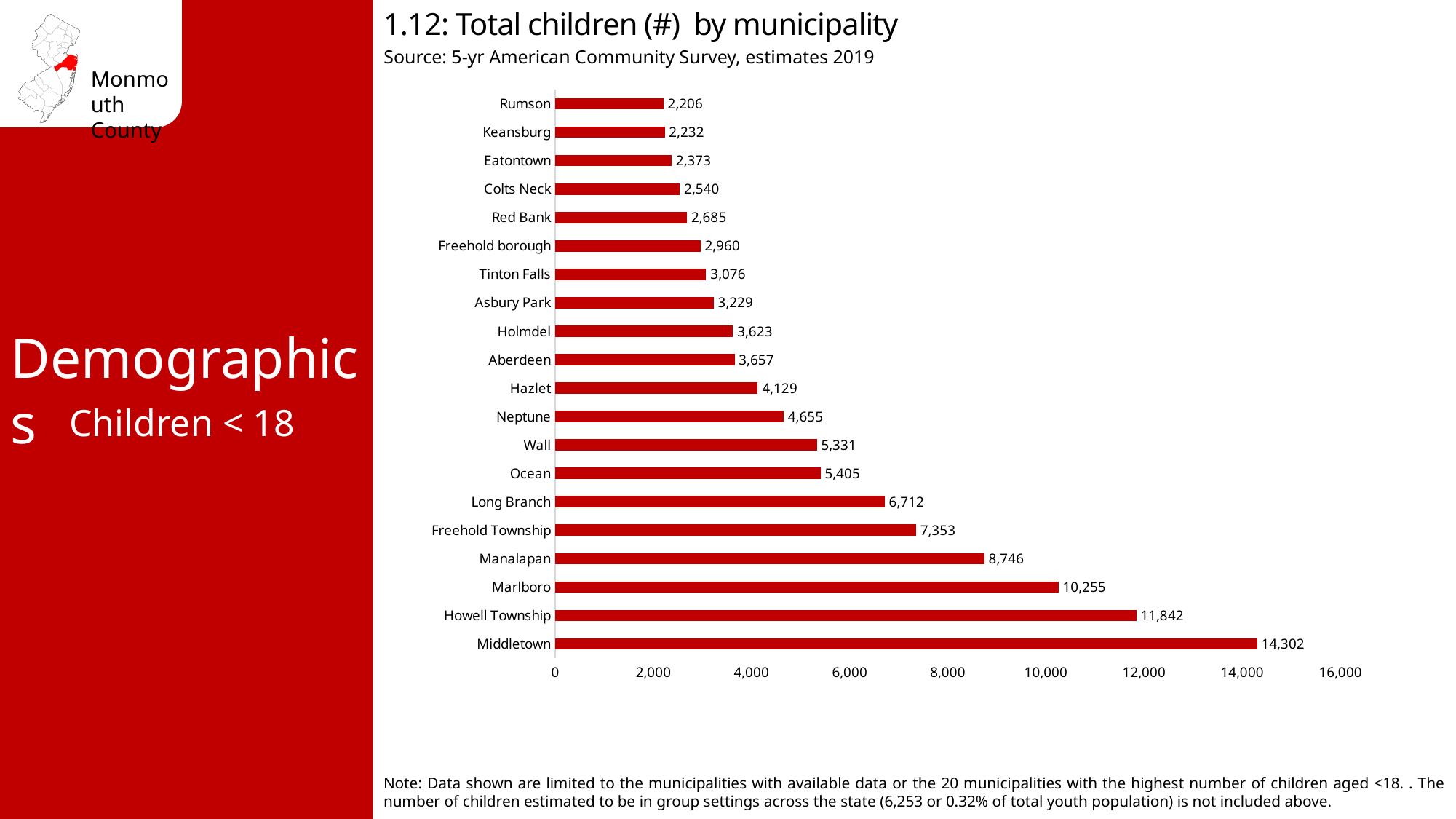
Is the value for Marlboro greater or less than 10,000? greater What is the total number of children in Neptune? 4,655 Which has more children, Long Branch or Ocean? Long Branch Which municipality has the lowest number of children? Rumson What is the total number of children in Middletown? 14,302 What kind of chart is shown on the slide? Bar chart Which municipality has the highest number of children? Middletown What is the difference in the number of children between Howell Township and Marlboro? 1,587 What is the difference in the number of children between Manalapan and Freehold Township? 1,393 How many municipalities are shown in the chart? 20 What is the source of the data shown in the chart? 5-yr American Community Survey, estimates 2019 What is the total number of children in Freehold borough? 2,960